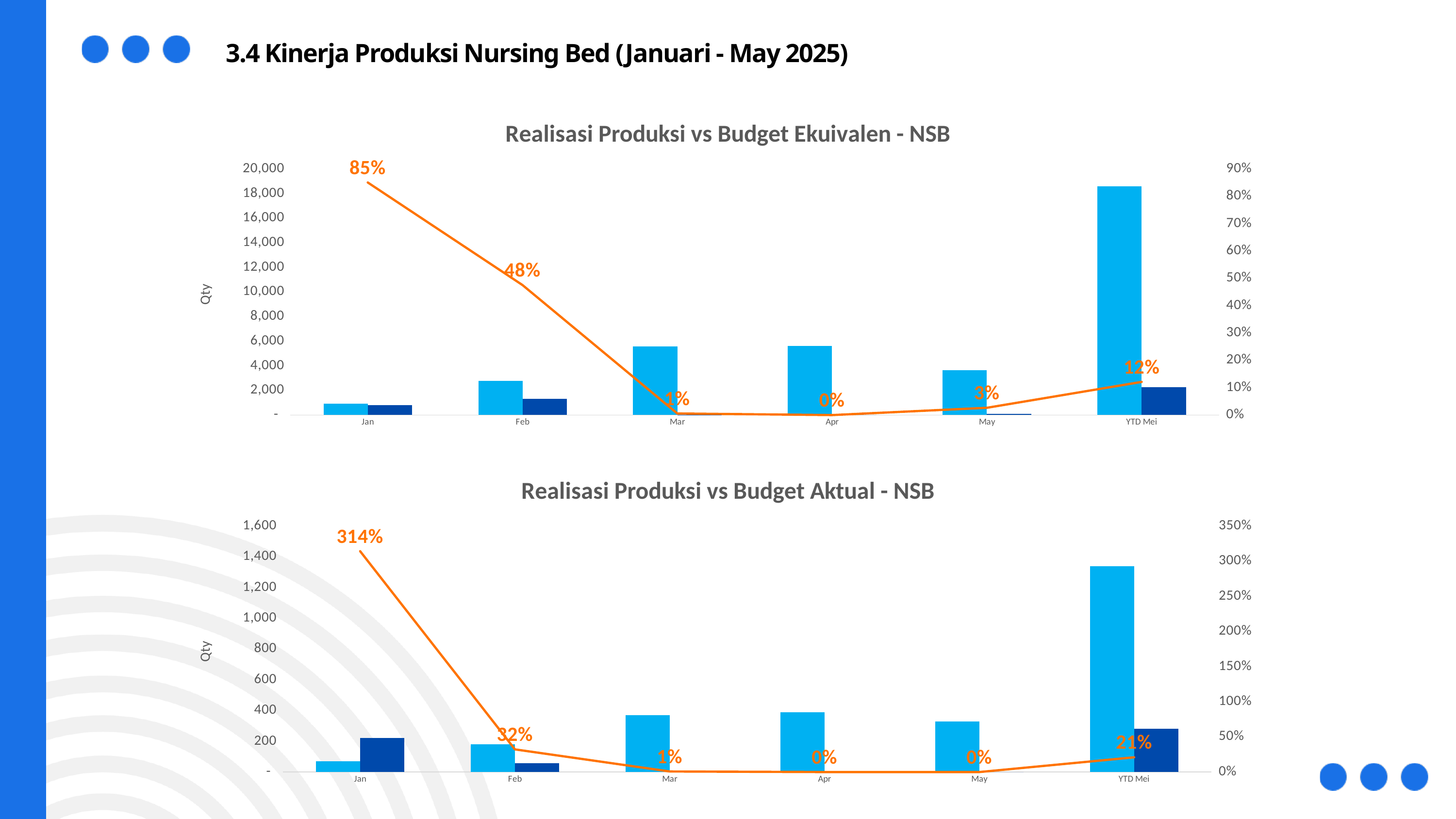
In the top chart 'Realisasi Produksi vs Budget Ekuivalen - NSB', what percentage is labelled on the line for Jan? 85% In the bottom chart 'Realisasi Produksi vs Budget Aktual - NSB', what percentage is labelled on the line for Jan? 314% In the top chart 'Realisasi Produksi vs Budget Ekuivalen - NSB', what percentage is labelled on the line for YTD Mei? 12% In the bottom chart 'Realisasi Produksi vs Budget Aktual - NSB', what percentage is labelled on the line for YTD Mei? 21% In the top chart 'Realisasi Produksi vs Budget Ekuivalen - NSB', what percentage is labelled on the line for Feb? 48% In the top chart 'Realisasi Produksi vs Budget Ekuivalen - NSB', what is the difference between the line percentages for Jan and Feb? 37% In the top chart 'Realisasi Produksi vs Budget Ekuivalen - NSB', which category has the highest line percentage? Jan In the bottom chart 'Realisasi Produksi vs Budget Aktual - NSB', which category has the lowest line percentage, Feb or Mar? Mar In the bottom chart 'Realisasi Produksi vs Budget Aktual - NSB', is the light blue bar for YTD Mei greater or less than 1,200? greater In the top chart 'Realisasi Produksi vs Budget Ekuivalen - NSB', is the light blue bar for YTD Mei greater or less than 16,000? greater How many categories are shown on the x axis of the top chart 'Realisasi Produksi vs Budget Ekuivalen - NSB'? 6 In the bottom chart 'Realisasi Produksi vs Budget Aktual - NSB', does the line percentage rise or fall from Jan to Apr? fall